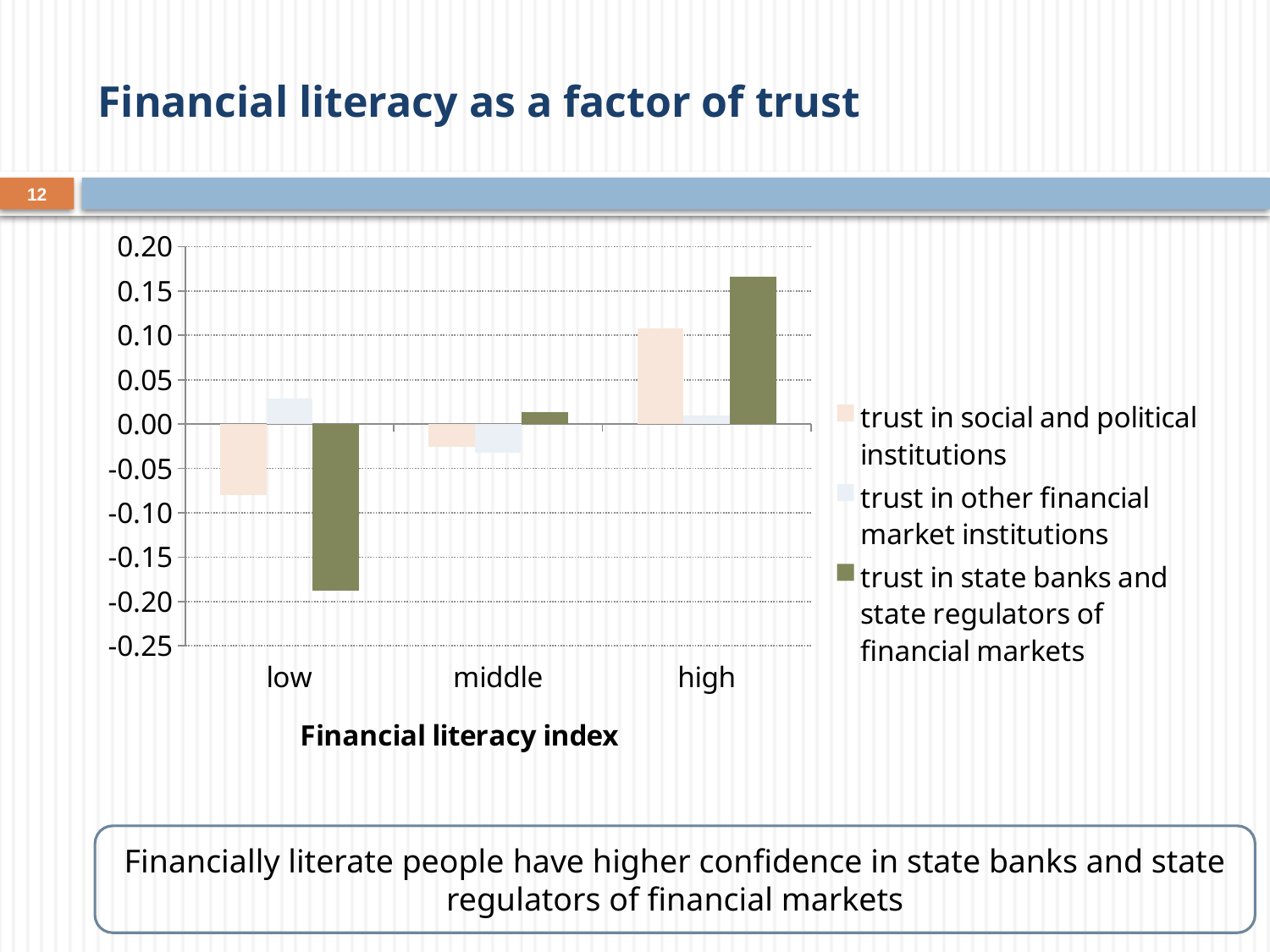
How many categories are shown on the x axis of the chart? 3 Is the value for 'trust in state banks and state regulators of financial markets' in the high category greater or less than 0.15? greater What kind of chart is shown on the slide? bar chart For the series 'trust in state banks and state regulators of financial markets', which financial literacy category has the lowest value? low Is the value for 'trust in state banks and state regulators of financial markets' in the low category greater or less than -0.15? less What is the title of the chart's x axis? Financial literacy index Does the value for 'trust in state banks and state regulators of financial markets' rise or fall as the financial literacy index goes from low to high? rise For the series 'trust in state banks and state regulators of financial markets', which financial literacy category has the highest value? high Is the value for 'trust in social and political institutions' in the high category greater or less than 0.05? greater How many series does the chart's legend list? 3 In the high category, which is larger: 'trust in social and political institutions' or 'trust in state banks and state regulators of financial markets'? trust in state banks and state regulators of financial markets